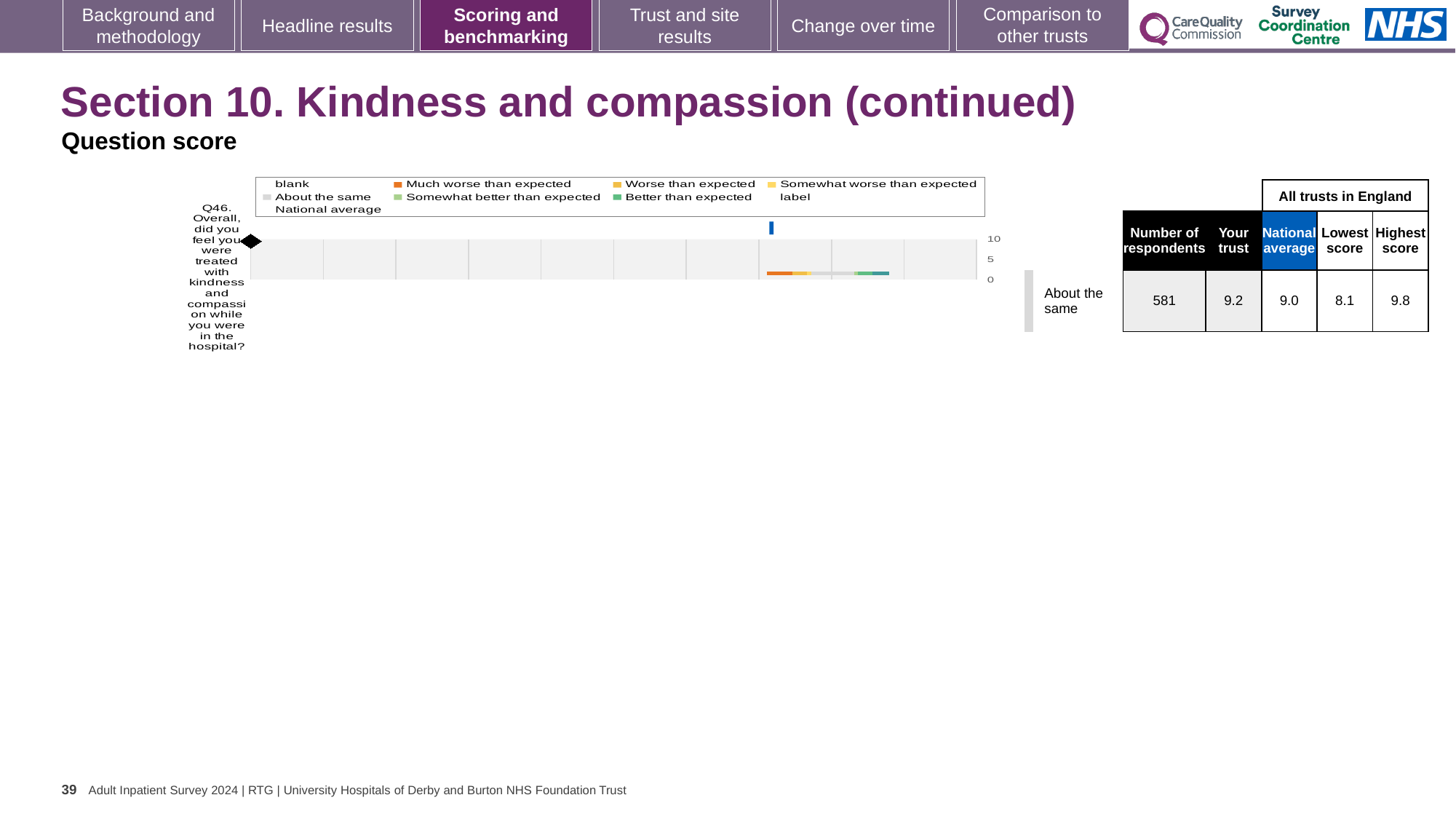
What is the difference between the 'Your trust' score and the national average for Q46? 0.2 What is the national average score for Q46 shown on this slide? 9.0 How many respondents answered Q46 for this trust? 581 What colour is used in the legend for 'Much worse than expected'? orange What is the lowest score among all trusts in England for Q46? 8.1 What is the highest score among all trusts in England for Q46? 9.8 Which benchmark category is Q46 placed in on this slide? About the same What is the difference between the highest score and the lowest score for Q46? 1.7 What kind of chart is shown for Q46 on this slide? bar chart How many questions are plotted in the chart on this slide? 1 What is the 'Your trust' score for Q46 shown on this slide? 9.2 Which is larger for Q46: the 'Your trust' score or the national average? Your trust